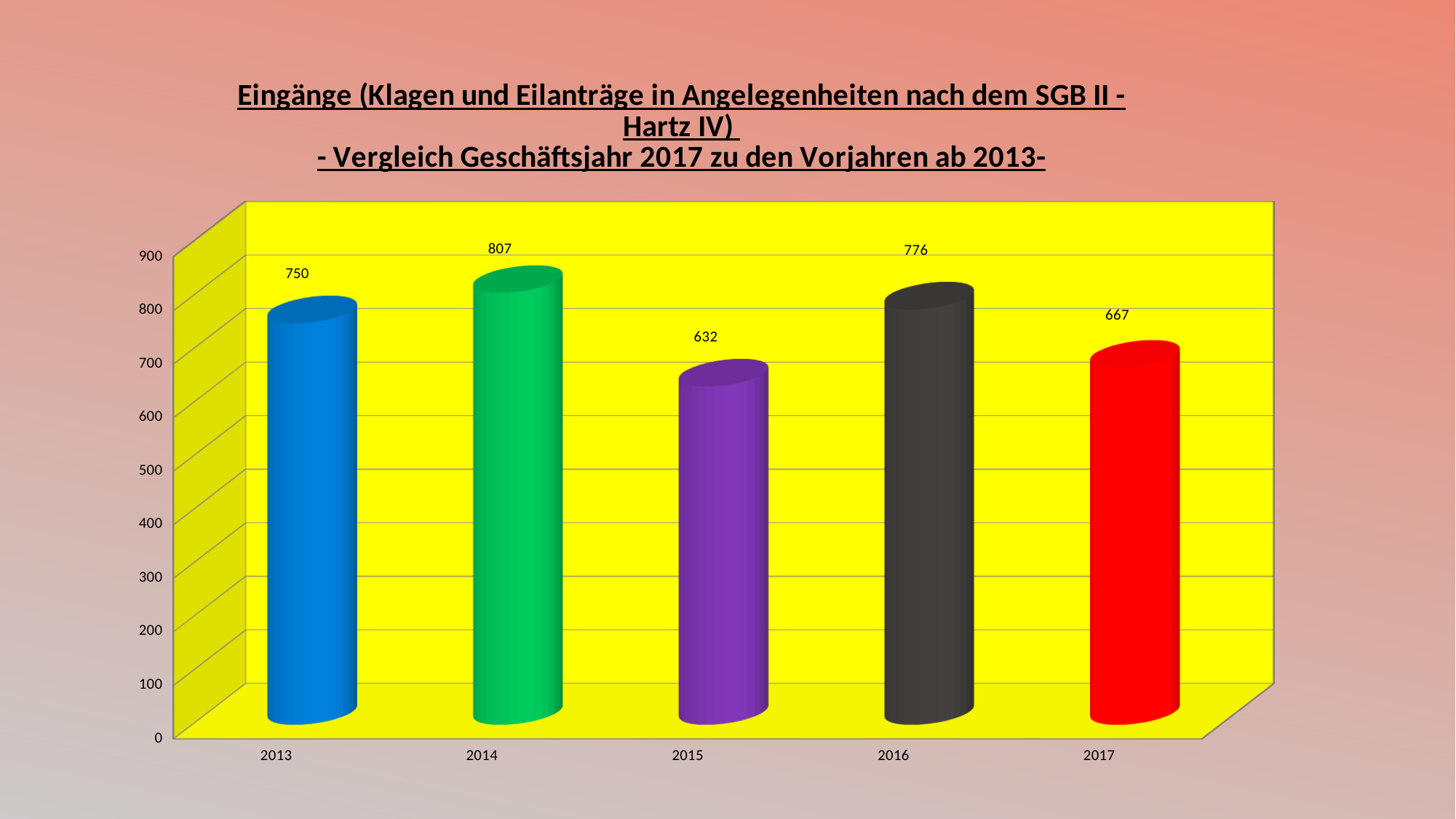
Which year has the lowest value? 2015 What is the difference between the values for 2014 and 2017? 140 How many years are shown on the x axis? 5 What is the value for 2017? 667 What is the value for 2013? 750 What colour is the bar for 2016? black Which year has the highest value? 2014 What is the value for 2015? 632 What is the difference between the values for 2016 and 2015? 144 What kind of chart is this? bar chart Which is larger, the value for 2013 or the value for 2016? 2016 Is the value for 2014 greater or less than 800? greater